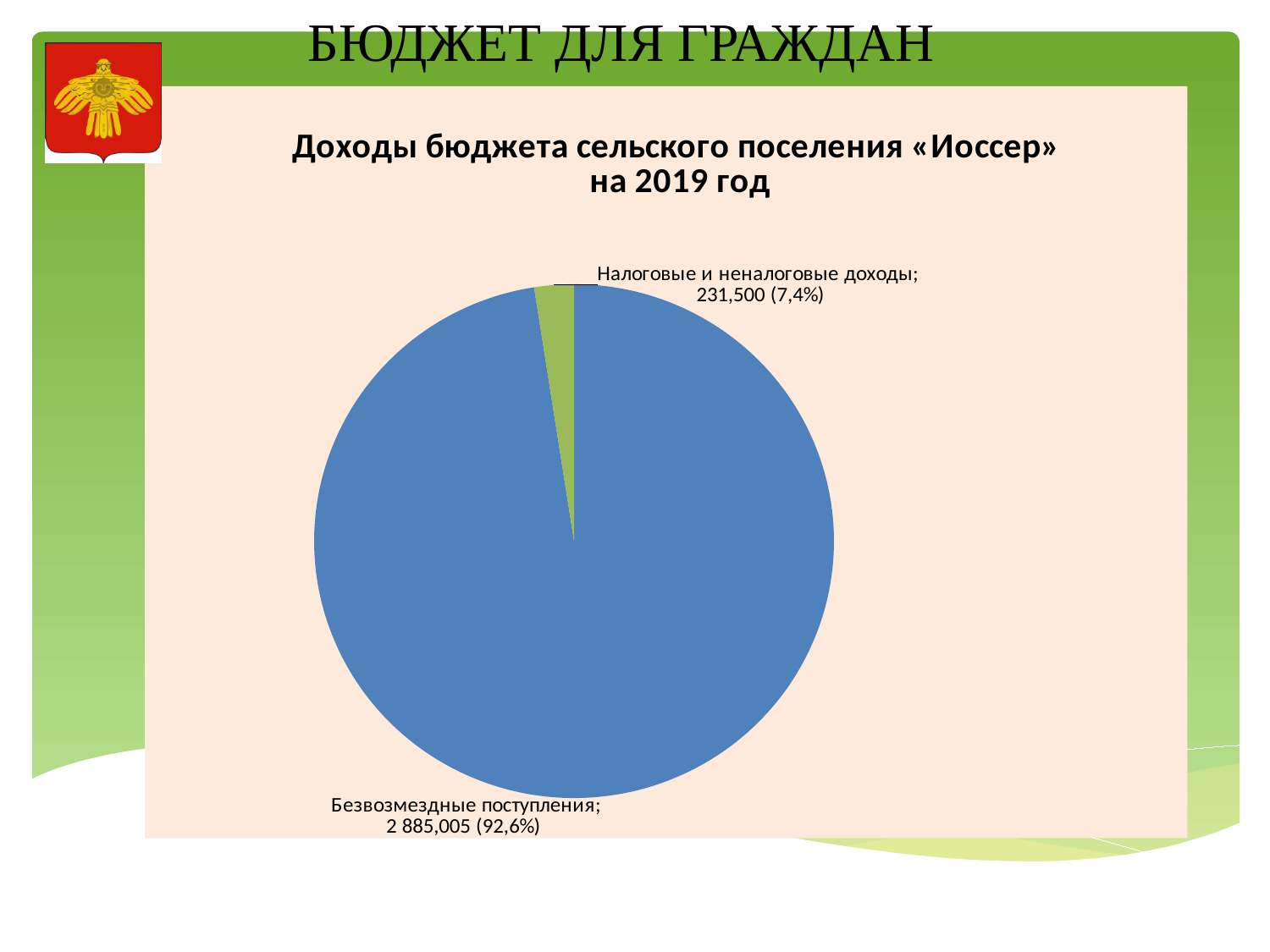
Which is larger: Безвозмездные поступления or Налоговые и неналоговые доходы? Безвозмездные поступления Which category has the largest slice of the pie? Безвозмездные поступления Which category has the smallest slice of the pie? Налоговые и неналоговые доходы What is the value shown for Налоговые и неналоговые доходы? 231,500 What is the value shown for Безвозмездные поступления? 2 885,005 What colour is the slice for Налоговые и неналоговые доходы? green How many slices does the pie chart have? 2 What is the title of the chart? Доходы бюджета сельского поселения «Иоссер» на 2019 год What share of the pie does Налоговые и неналоговые доходы take? 7,4% What is the difference between the values for Безвозмездные поступления and Налоговые и неналоговые доходы? 2 653,505 What kind of chart is shown on the slide? pie chart What share of the pie does Безвозмездные поступления take? 92,6%